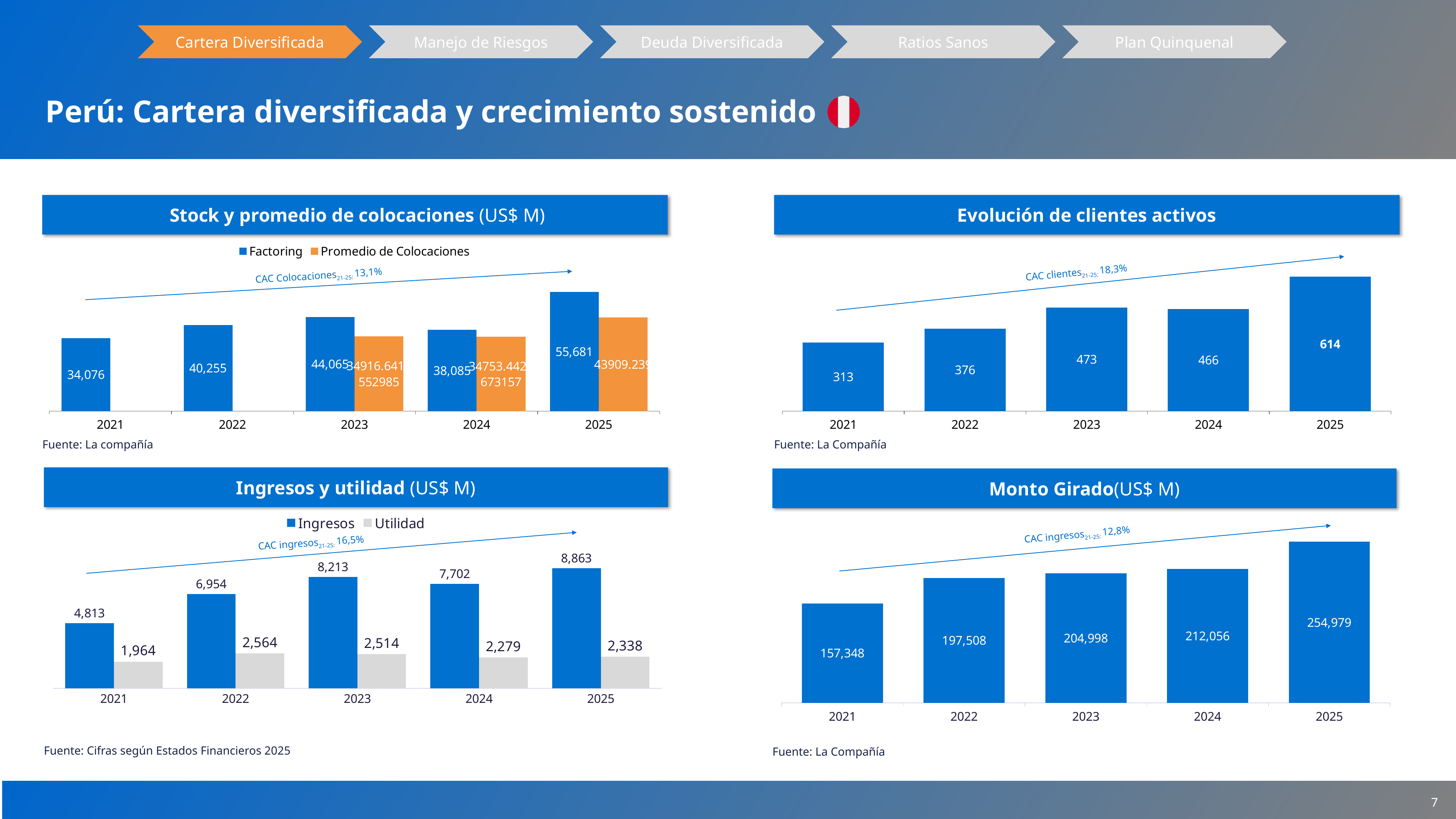
In the 'Ingresos y utilidad' chart, which is larger: Ingresos in 2023 or Ingresos in 2024? 2023 In the 'Ingresos y utilidad' chart, what is the Utilidad value for 2022? 2,564 In the 'Monto Girado' chart, do the values rise or fall from 2021 to 2025? rise What kind of chart is the 'Monto Girado' chart? bar chart In the 'Ingresos y utilidad' chart, what is the difference between Ingresos and Utilidad in 2025? 6,525 In the 'Stock y promedio de colocaciones' chart, what is the Factoring value for 2025? 55,681 In the 'Evolución de clientes activos' chart, what is the value for 2023? 473 In the 'Evolución de clientes activos' chart, which year has the highest value? 2025 In the 'Stock y promedio de colocaciones' chart, how many series does the legend list? 2 In the 'Monto Girado' chart, what is the value for 2024? 212,056 In the 'Stock y promedio de colocaciones' chart, which year has the lowest Factoring value? 2021 In the 'Evolución de clientes activos' chart, what is the difference between the 2025 and 2021 values? 301